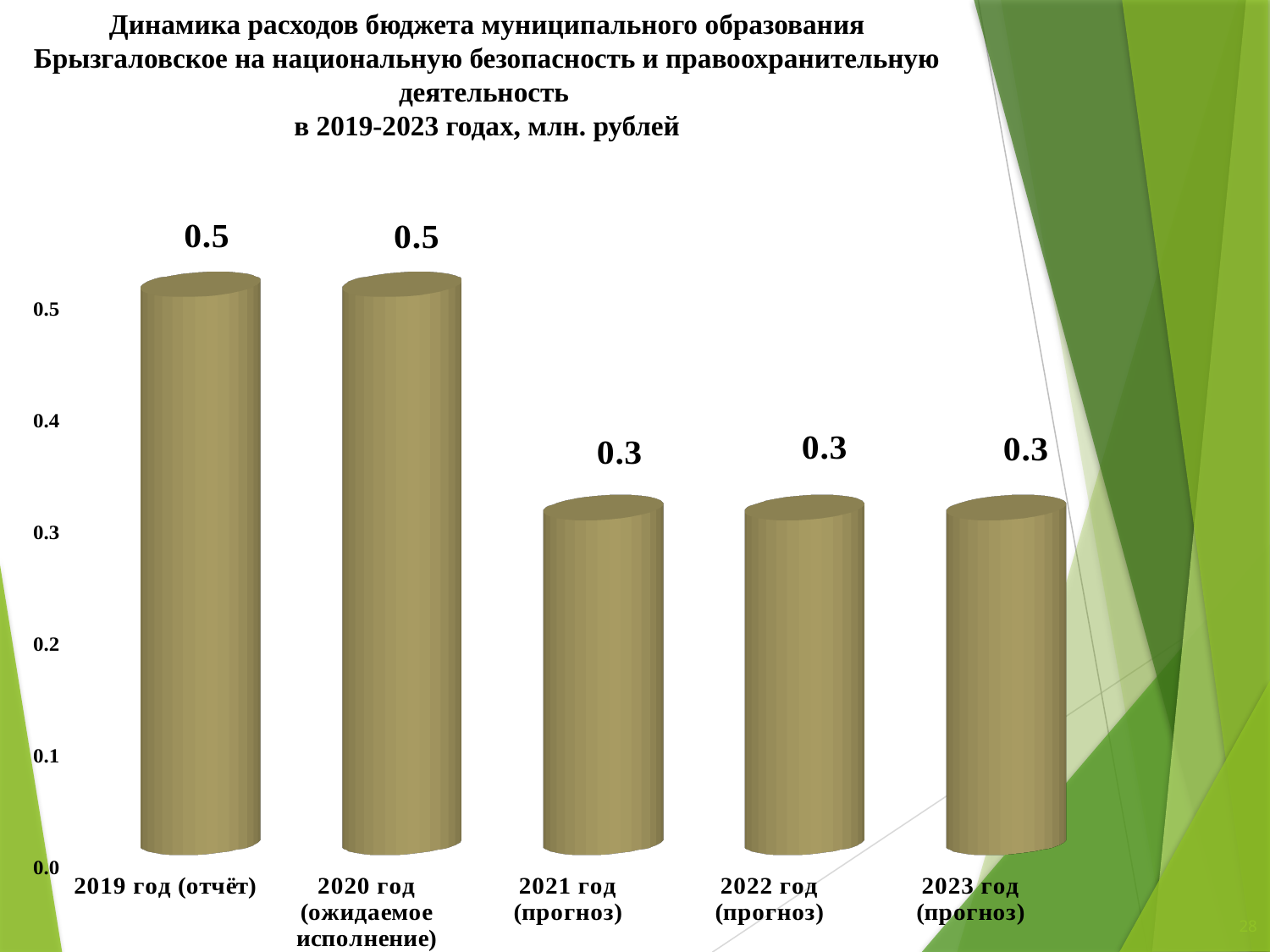
What is the difference between the values for 2020 год (ожидаемое исполнение) and 2022 год (прогноз)? 0.2 Do the values rise or fall from 2019 to 2023 along the x axis? fall How many categories are shown on the x axis? 5 In what units are the values on the chart expressed, according to the title? млн. рублей What is the value for 2021 год (прогноз)? 0.3 Which is larger, the value for 2019 год (отчёт) or the value for 2021 год (прогноз)? 2019 год (отчёт) Is the value for 2020 год (ожидаемое исполнение) greater or less than 0.4? greater What is the value for 2019 год (отчёт)? 0.5 What is the value for 2023 год (прогноз)? 0.3 What is the value for 2020 год (ожидаемое исполнение)? 0.5 What kind of chart is shown on the slide? bar chart Is the value for 2022 год (прогноз) greater or less than 0.4? less